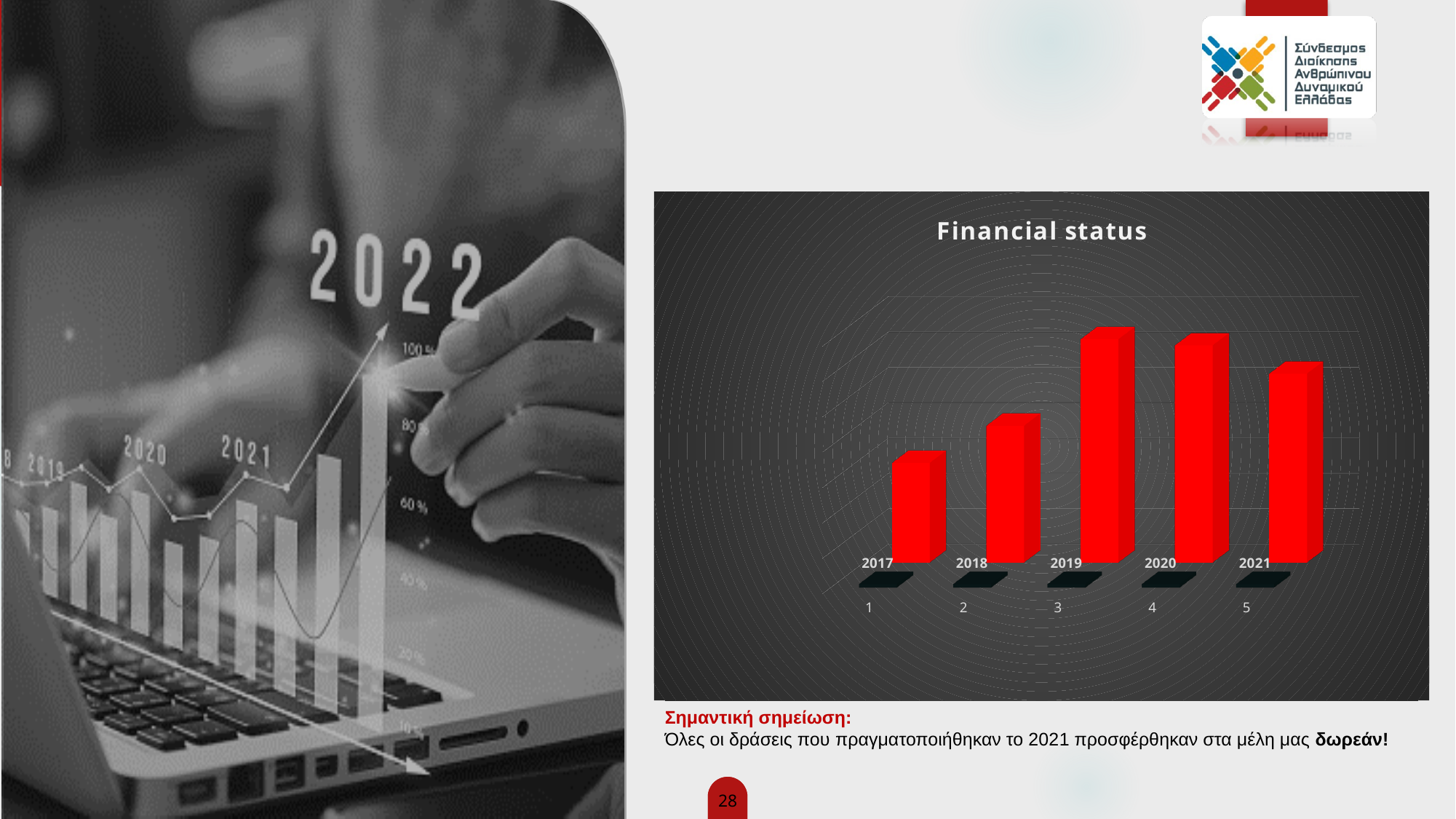
In the "Financial status" chart, do the values rise or fall from 2019 to 2021? fall Which year has the highest bar in the "Financial status" chart? 2019 In the "Financial status" chart, which is larger, the value for 2020 or the value for 2021? 2020 In the "Financial status" chart, which is larger, the value for 2018 or the value for 2021? 2021 In the "Financial status" chart, do the values rise or fall from 2017 to 2019? rise What is the title of the chart on the slide? Financial status What is the first year shown on the x axis of the "Financial status" chart? 2017 How many bars (years) are plotted in the "Financial status" chart? 5 What kind of chart is shown under the title "Financial status"? bar chart In the "Financial status" chart, which is larger, the value for 2017 or the value for 2018? 2018 What colour are the bars in the "Financial status" chart? red Which year has the lowest bar in the "Financial status" chart? 2017